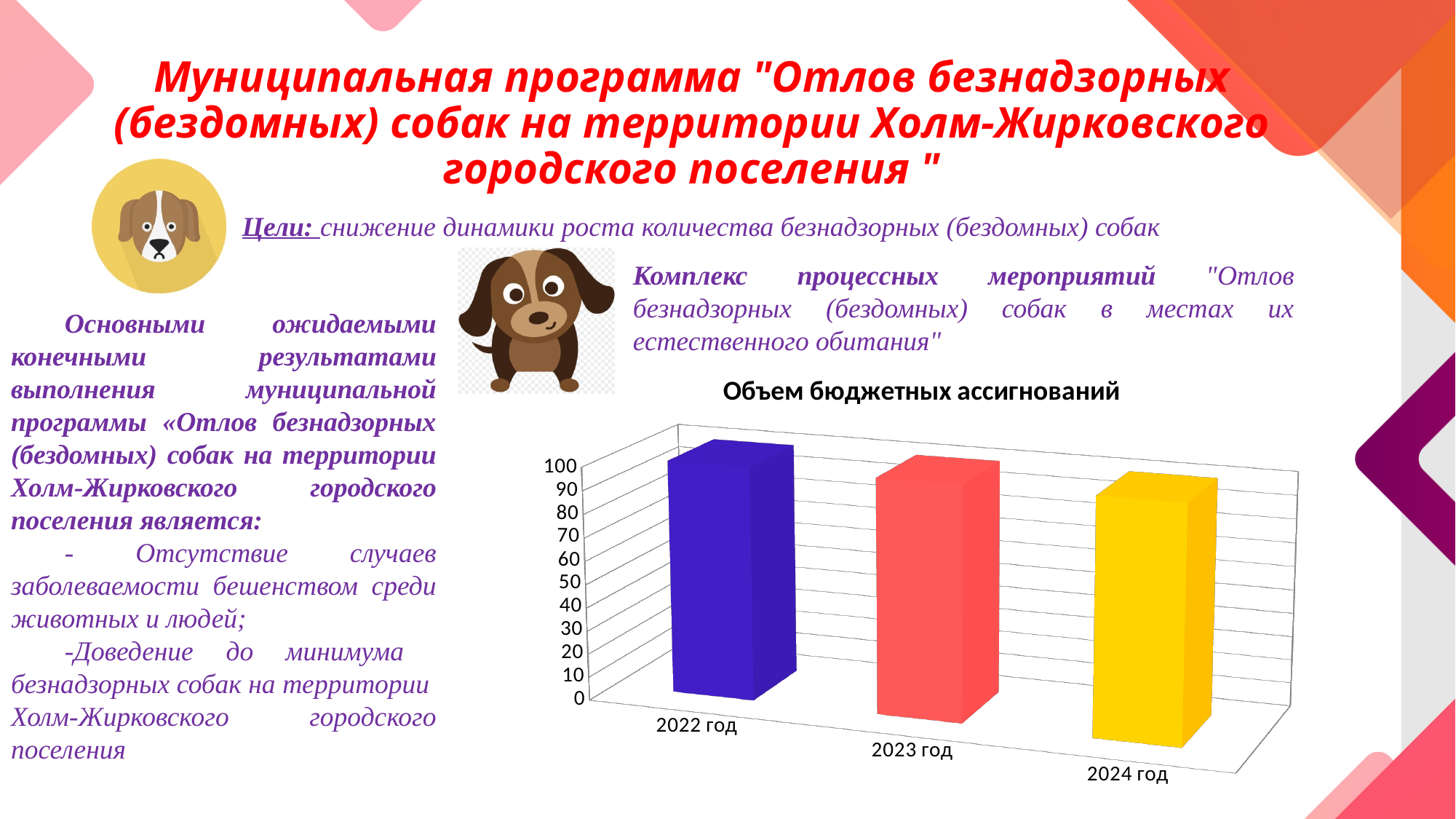
What is the title of the chart on the slide? Объем бюджетных ассигнований Which years are shown on the x axis of the "Объем бюджетных ассигнований" chart? 2022 год, 2023 год, 2024 год What kind of chart is shown under the title "Объем бюджетных ассигнований"? bar chart Is the value for 2023 год greater or less than 60? greater Is the value for 2024 год greater or less than 50? greater Is the value for 2022 год greater or less than 70? greater What is the highest tick value shown on the vertical axis of the chart? 100 How many categories (years) are plotted in the "Объем бюджетных ассигнований" chart? 3